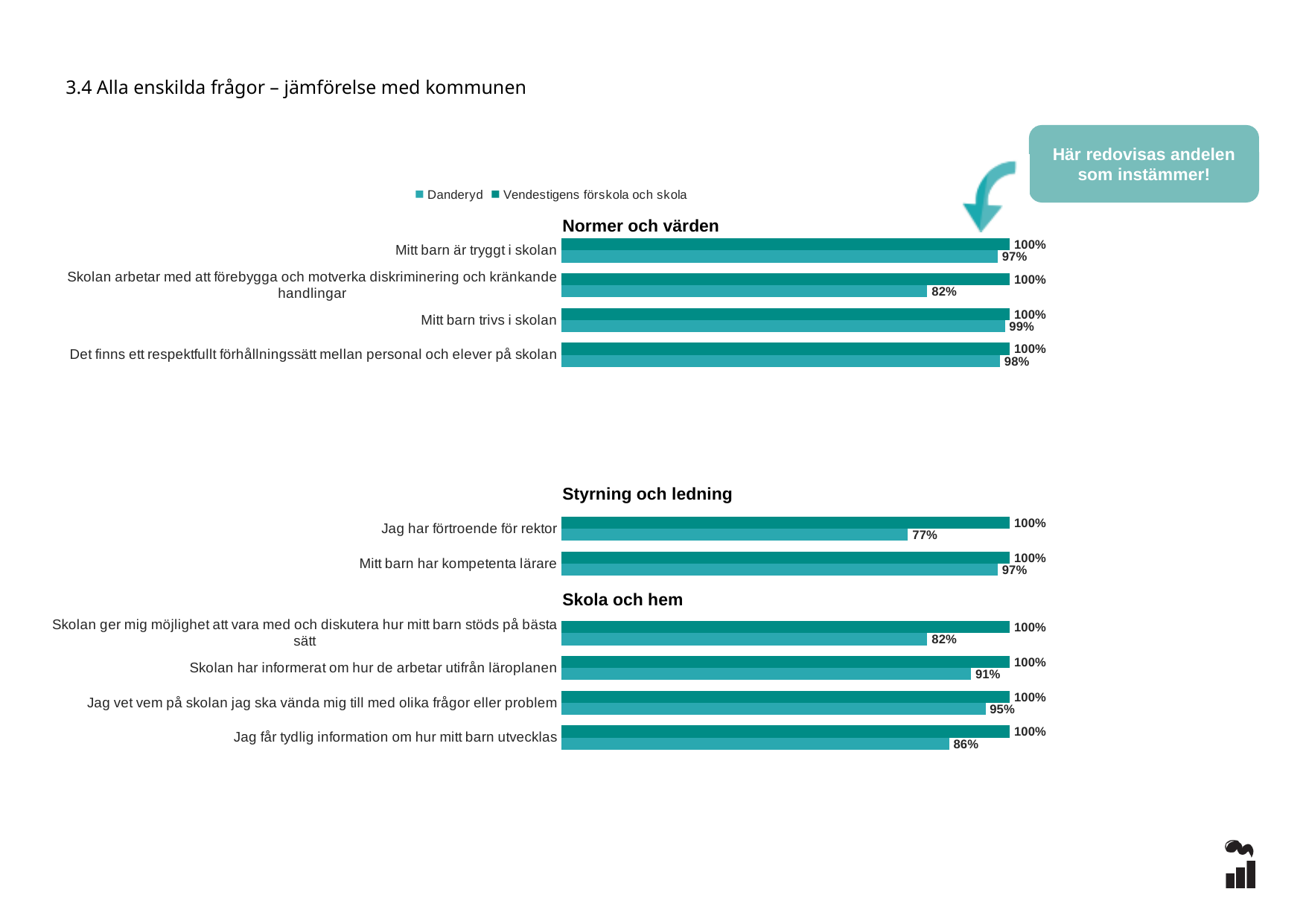
Which has a higher Danderyd value: "Mitt barn har kompetenta lärare" or "Jag har förtroende för rektor"? Mitt barn har kompetenta lärare What is the Danderyd value for "Mitt barn är tryggt i skolan"? 97% What is the Danderyd value for "Jag har förtroende för rektor"? 77% What type of chart is shown on the slide? Bar chart Under "Skola och hem", which question has the lowest Danderyd value? Skolan ger mig möjlighet att vara med och diskutera hur mitt barn stöds på bästa sätt What is the difference between the Danderyd values for "Skolan har informerat om hur de arbetar utifrån läroplanen" and "Jag får tydlig information om hur mitt barn utvecklas"? 5% How many series does the legend list? 2 What is the Vendestigens förskola och skola value for "Mitt barn trivs i skolan"? 100% What is the Danderyd value for "Jag får tydlig information om hur mitt barn utvecklas"? 86% How many questions are shown under the "Skola och hem" heading? 4 Under "Normer och värden", which question has the highest Danderyd value? Mitt barn trivs i skolan What is the difference between the Vendestigens förskola och skola value and the Danderyd value for "Jag har förtroende för rektor"? 23%